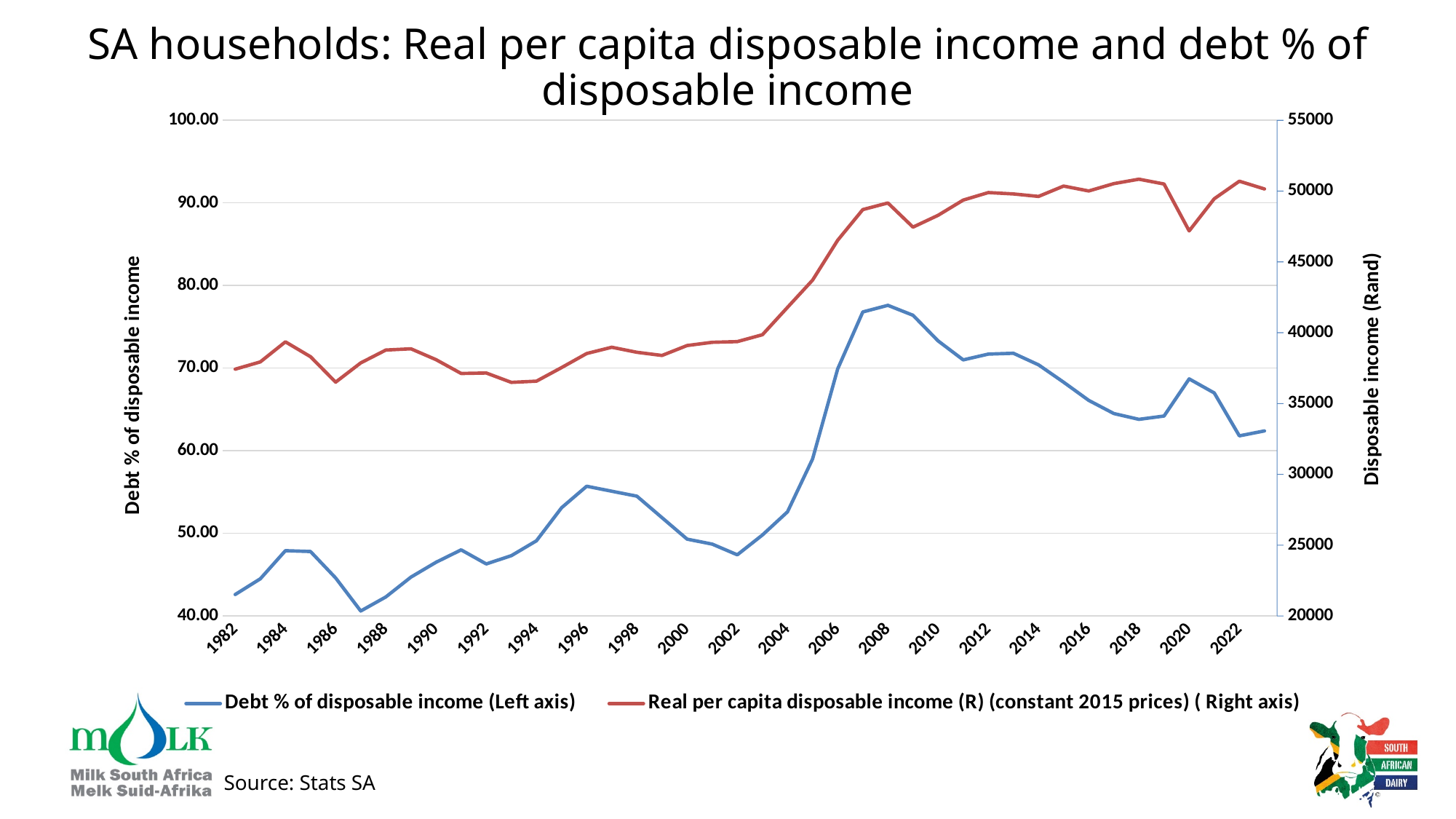
Does Debt % of disposable income rise or fall between 2008 and 2018? fall Is the value for Debt % of disposable income in 2008 greater or less than 70? greater Does Real per capita disposable income rise or fall between 2004 and 2008? rise Is the value for Real per capita disposable income in 1982 greater or less than 40000? less Which series is plotted in red? Real per capita disposable income (R) (constant 2015 prices) ( Right axis) What kind of chart is shown on the slide? Line chart How many series does the legend list? 2 Is the value for Real per capita disposable income in 2020 greater or less than 45000? greater In which year is Debt % of disposable income at its lowest? 1987 What is the label of the right-hand vertical axis? Disposable income (Rand)